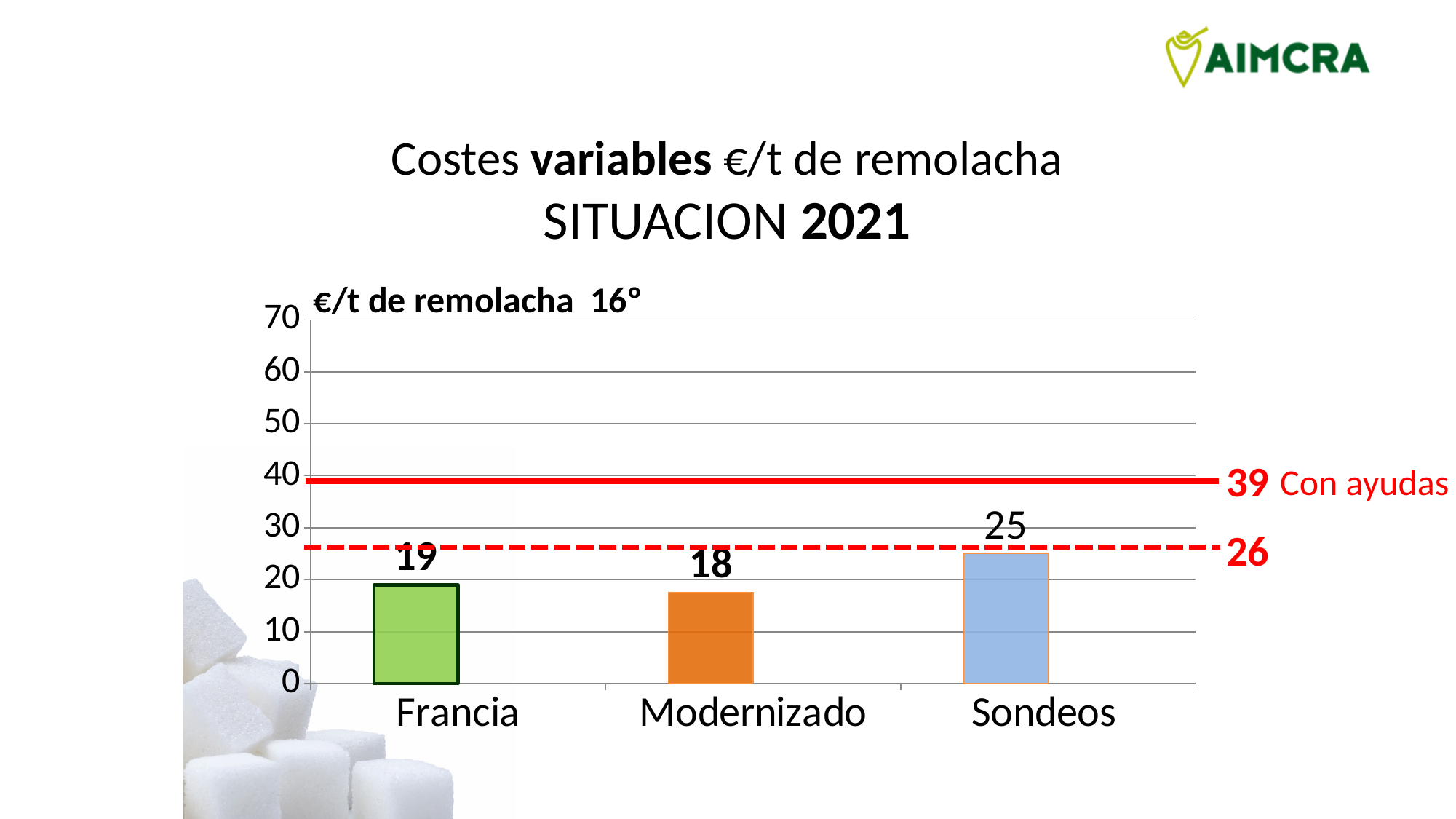
Which category has the highest value? Sondeos Which category has the lowest value? Modernizado What value is marked by the solid red line labelled 'Con ayudas'? 39 What is the value for Sondeos? 25 What is the difference between the values for Sondeos and Modernizado? 7 Is the value for Sondeos greater or less than 30? less What kind of chart is shown on the slide? bar chart What is the value for Francia? 19 What is the value for Modernizado? 18 Which is larger, the value for Sondeos or the value for Francia? Sondeos What is the difference between the values for Francia and Modernizado? 1 How many categories are shown on the x axis? 3